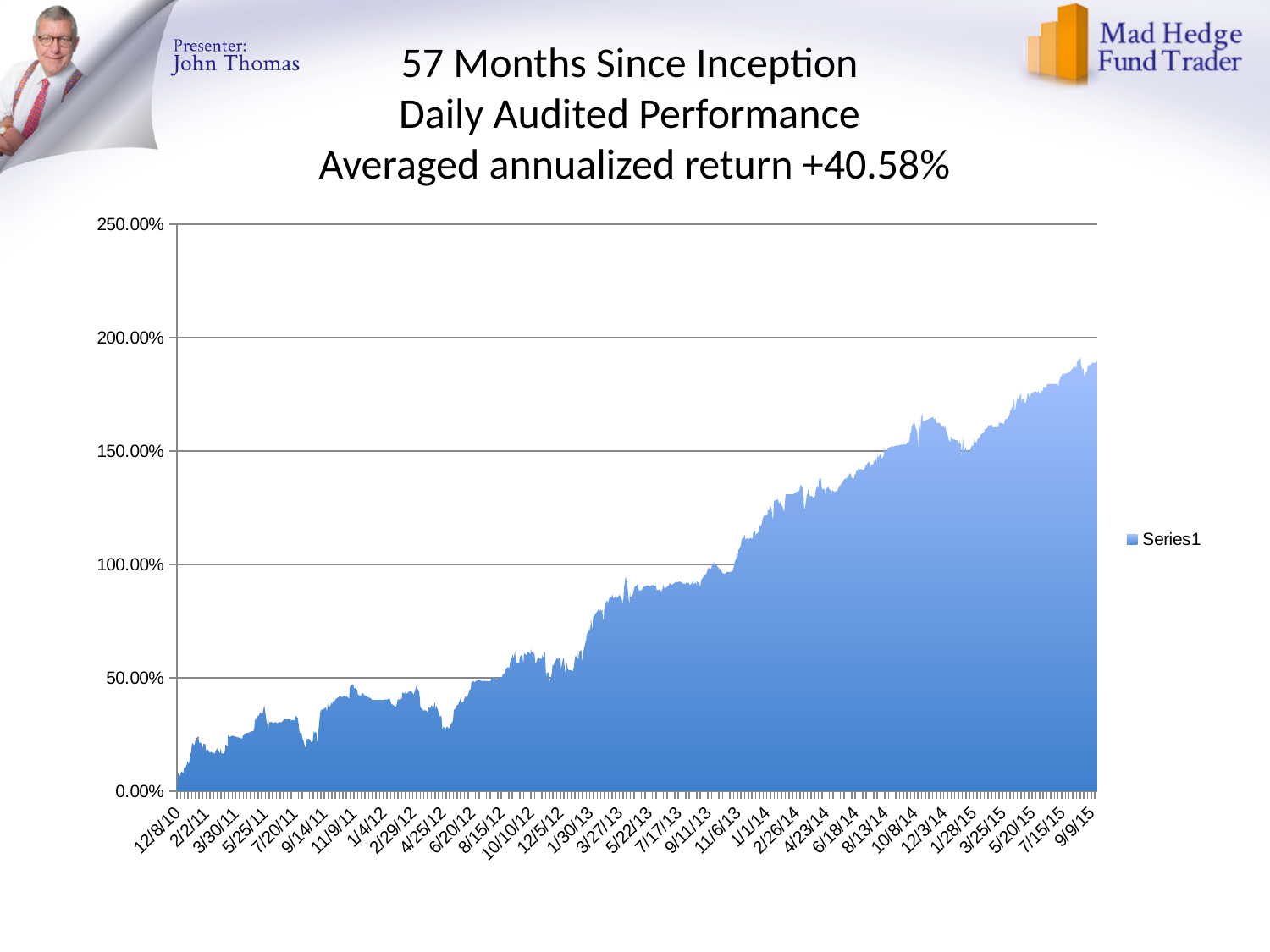
What is the averaged annualized return stated in the chart title? +40.58% Is the value at 8/15/12 greater or less than 100.00%? less Which is larger, the value at 12/8/10 or the value at 9/9/15? 9/9/15 Overall, do the values rise or fall from 12/8/10 to 9/9/15? rise Is the value at 9/9/15 greater or less than 150.00%? greater How many series does the legend list? 1 Is the value at 12/8/10 greater or less than 50.00%? less What is the name of the series shown in the legend? Series1 What kind of chart is shown on the slide? area chart